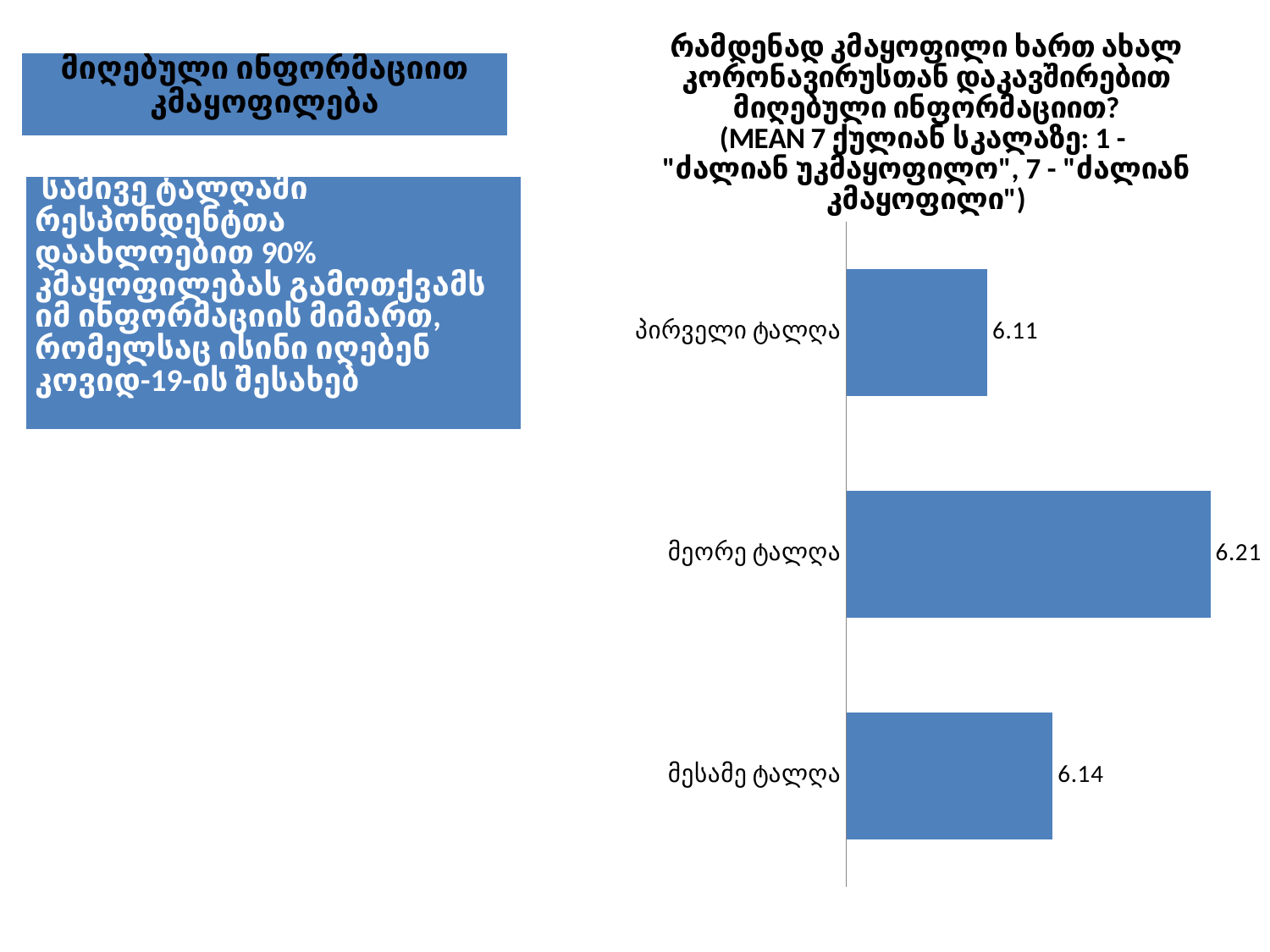
What is the difference between the values for მეორე ტალღა and მესამე ტალღა? 0.07 Which category has the lowest value? პირველი ტალღა What is the difference between the values for მეორე ტალღა and პირველი ტალღა? 0.10 What is the value for მეორე ტალღა? 6.21 Which category has the highest value? მეორე ტალღა What kind of chart is shown on the slide? Bar chart How many categories are shown in the chart? 3 What is the value for მესამე ტალღა? 6.14 Which is larger, the value for მესამე ტალღა or the value for პირველი ტალღა? მესამე ტალღა What is the value for პირველი ტალღა? 6.11 What colour are the bars in the chart? Blue Do the values rise or fall from პირველი ტალღა to მეორე ტალღა? Rise